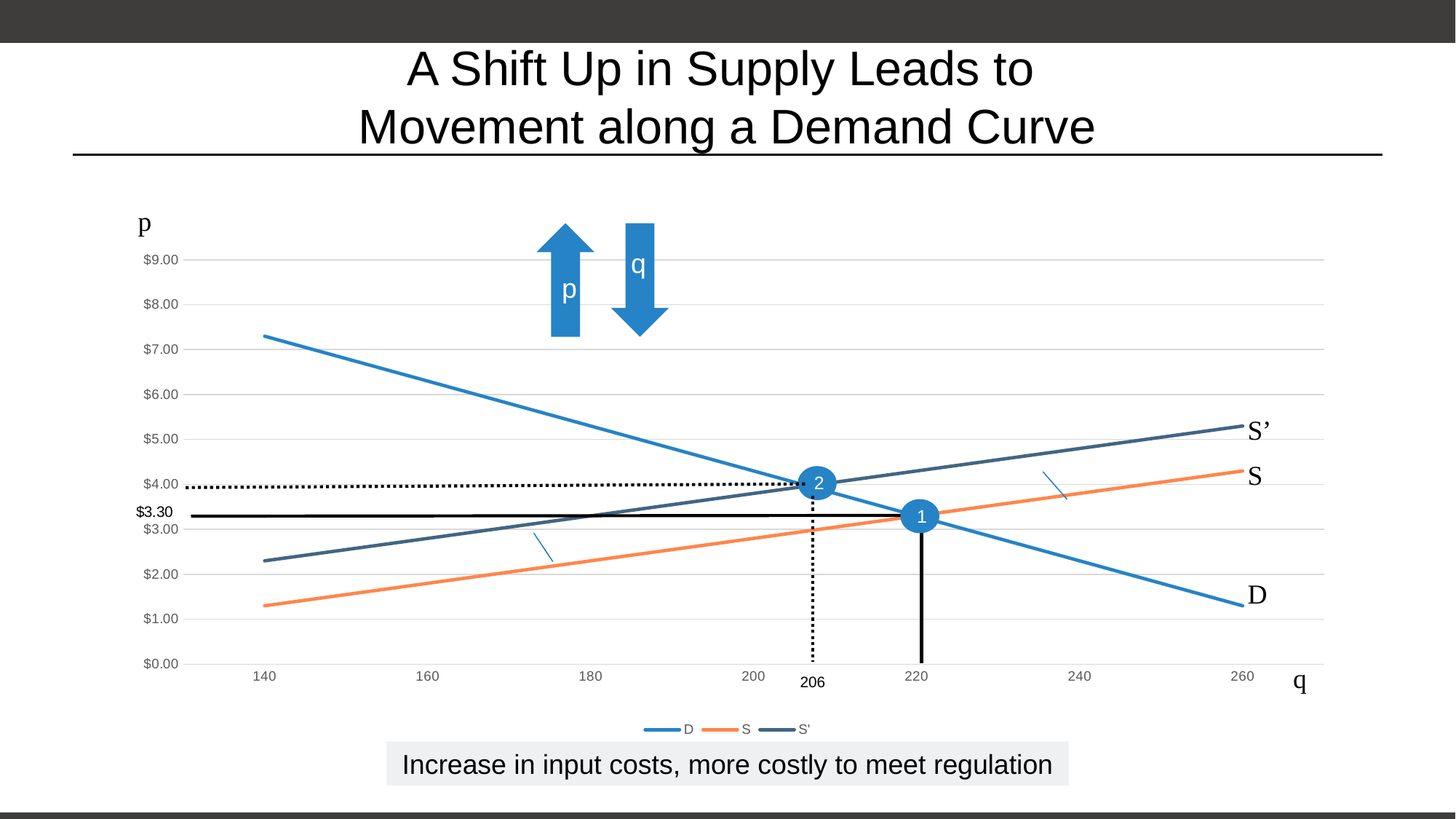
What is the quantity at equilibrium point 1? 220 By how much does the quantity fall from equilibrium point 1 to equilibrium point 2? 14 Is the value of the D line at q = 140 greater or less than $7.00? greater What kind of chart is shown on the slide? line chart Does the D line rise or fall as q increases? falls What are the series names listed in the legend? D, S, S' What is the price at equilibrium point 1? $3.30 Is the price at equilibrium point 2 greater or less than $3.00? greater At q = 260, which line is higher, S or S'? S' What is the quantity at equilibrium point 2? 206 Does the S' line rise or fall as q increases? rises How many series does the legend list? 3